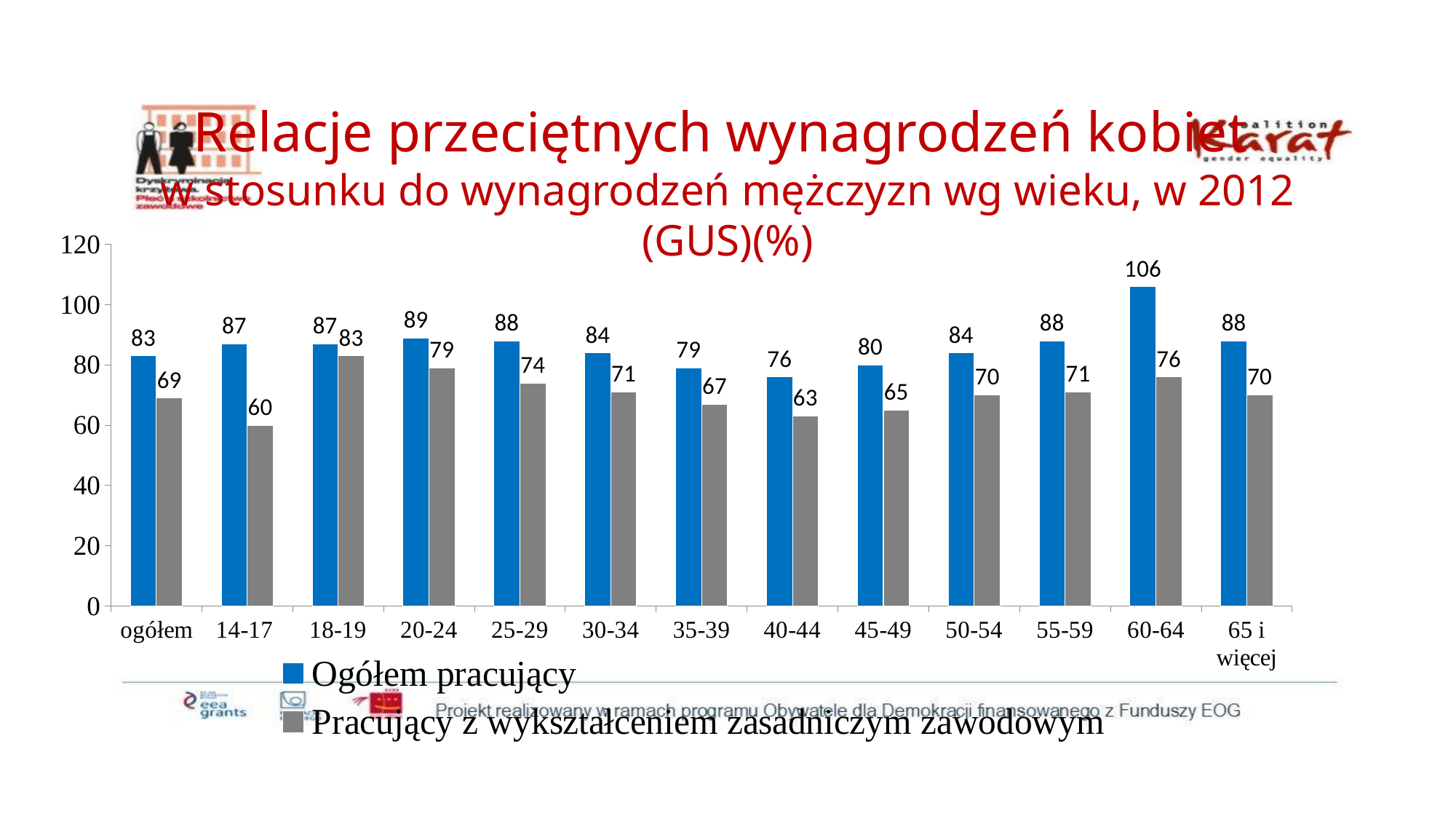
Which category has the lowest value for "Pracujący z wykształceniem zasadniczym zawodowym"? 14-17 How many series does the legend list? 2 Which category has the lowest value for "Ogółem pracujący"? 40-44 Which age group has the highest value for "Ogółem pracujący"? 60-64 What is the value for "Ogółem pracujący" in the "ogółem" category? 83 Which is larger: the "Pracujący z wykształceniem zasadniczym zawodowym" value for 18-19 or for 20-24? 18-19 What is the value for "Pracujący z wykształceniem zasadniczym zawodowym" in the 14-17 age group? 60 What is the difference between the two series in the 14-17 age group? 27 What kind of chart is shown on the slide? Bar chart How many categories are shown on the x axis? 13 What is the difference between the "Ogółem pracujący" values for 60-64 and 65 i więcej? 18 What is the value for "Ogółem pracujący" in the 60-64 age group? 106